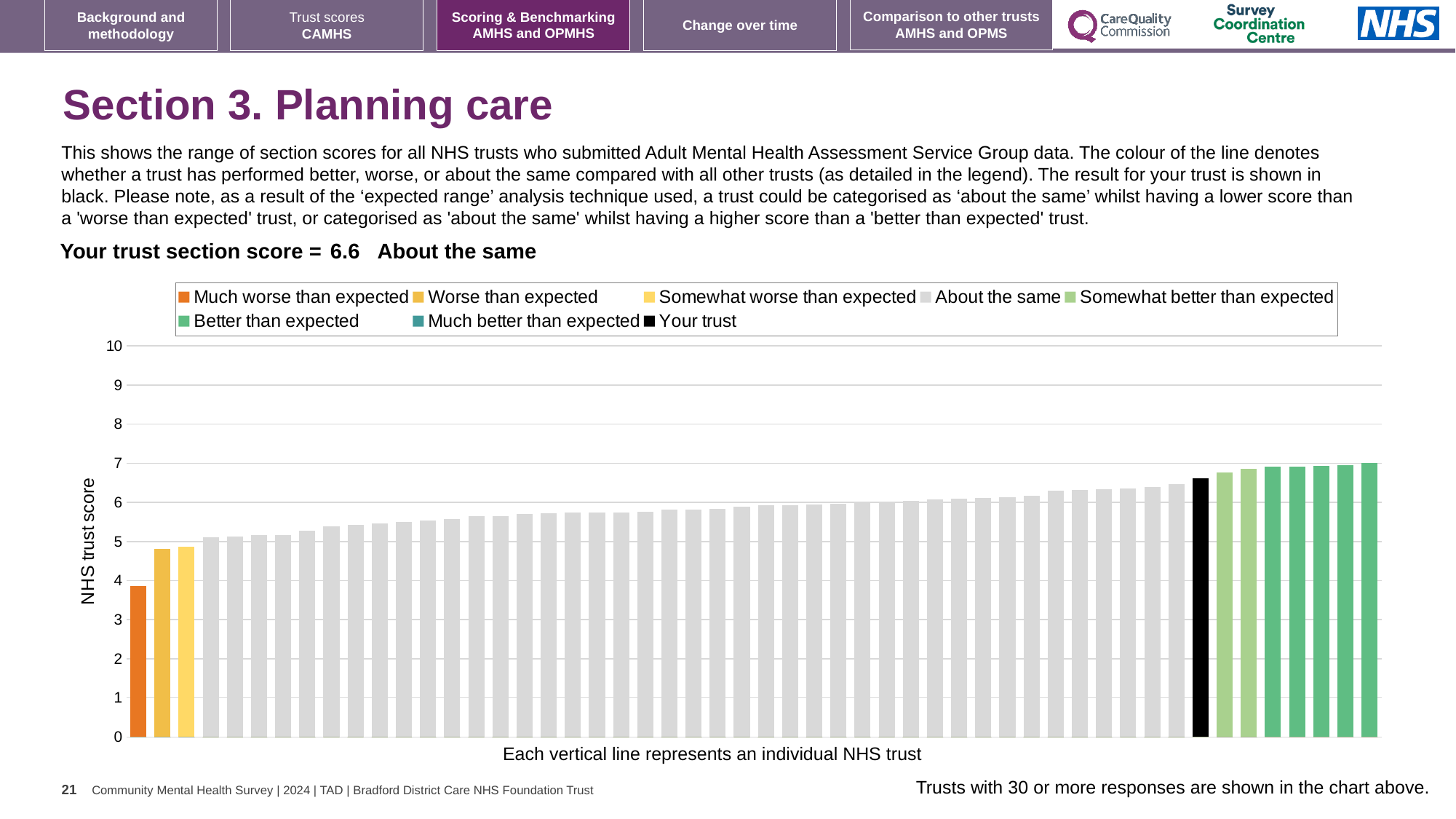
Is the value for the 'Your trust' bar greater or less than 6? greater Which legend category does the tallest bar belong to? Better than expected Is the value of the tallest bar greater or less than 8? less What is the label on the vertical axis of the chart? NHS trust score What is the section score for your trust? 6.6 Do the bar values rise or fall from left to right along the x axis? rise Is the 'Much worse than expected' bar taller or shorter than the 'Your trust' bar? shorter How many entries does the chart legend list? 8 Which legend category does the shortest bar belong to? Much worse than expected How many bars are coloured as 'Better than expected'? 5 Is the value for the 'Much worse than expected' bar greater or less than 5? less What kind of chart is shown on the slide? bar chart